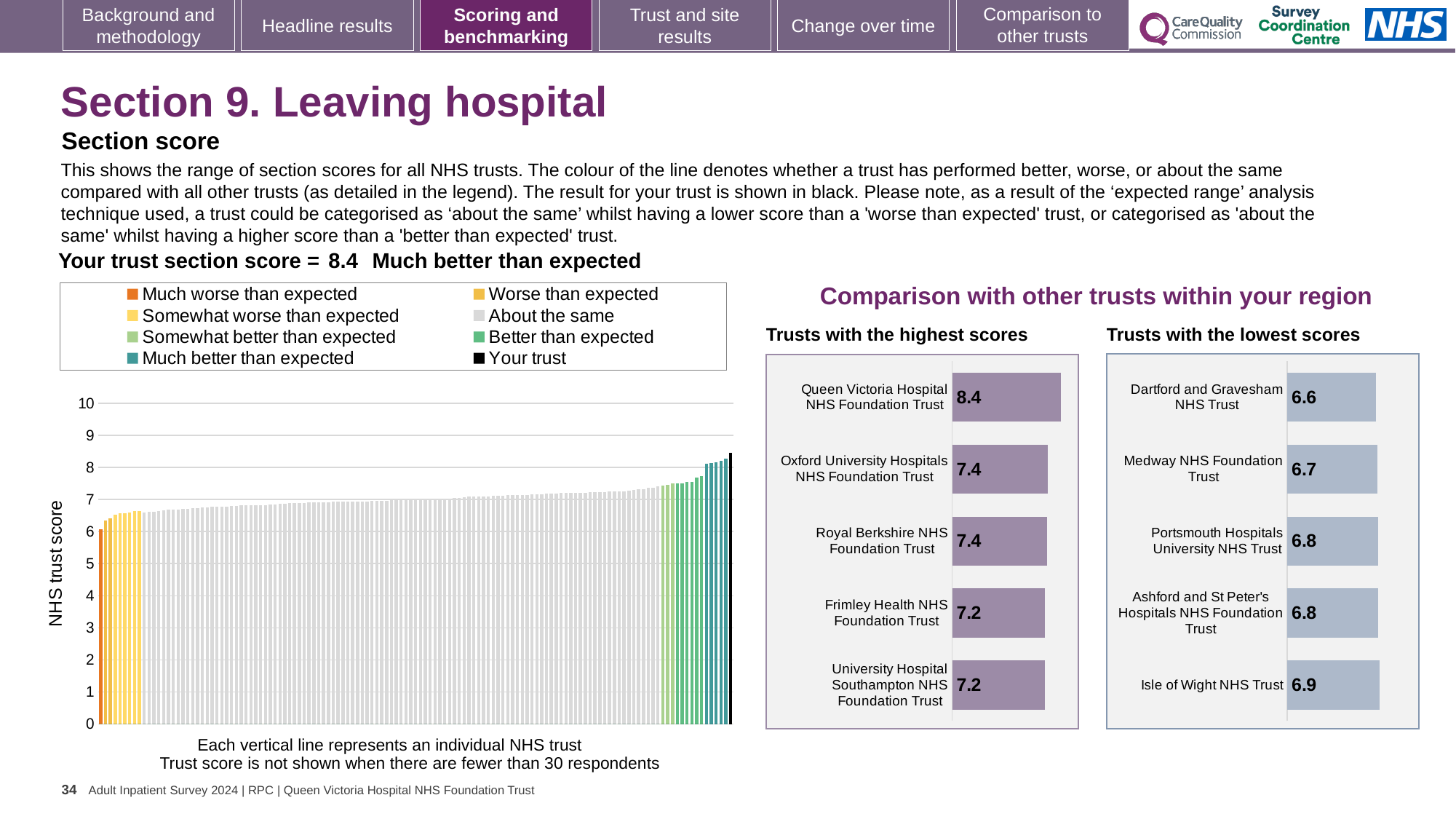
In the 'Trusts with the lowest scores' chart, what is the score for Isle of Wight NHS Trust? 6.9 In the 'Trusts with the highest scores' chart, which trust has the highest score? Queen Victoria Hospital NHS Foundation Trust In the NHS trust score chart on the left, is the value of the black 'Your trust' bar greater or less than 8? greater In the 'Trusts with the lowest scores' chart, which trust has the lowest score? Dartford and Gravesham NHS Trust In the 'Trusts with the highest scores' chart, what is the score for Queen Victoria Hospital NHS Foundation Trust? 8.4 In the NHS trust score chart on the left, do the values rise or fall from left to right? rise In the 'Trusts with the lowest scores' chart, which has the higher score: Medway NHS Foundation Trust or Isle of Wight NHS Trust? Isle of Wight NHS Trust In the 'Trusts with the highest scores' chart, what is the difference between the scores of Queen Victoria Hospital NHS Foundation Trust and Oxford University Hospitals NHS Foundation Trust? 1.0 What kind of chart is the NHS trust score chart on the left of the slide? bar chart In the 'Trusts with the lowest scores' chart, what is the difference between the scores of Isle of Wight NHS Trust and Dartford and Gravesham NHS Trust? 0.3 How many entries does the legend of the NHS trust score chart on the left list? 8 How many trusts are shown in the 'Trusts with the highest scores' chart? 5